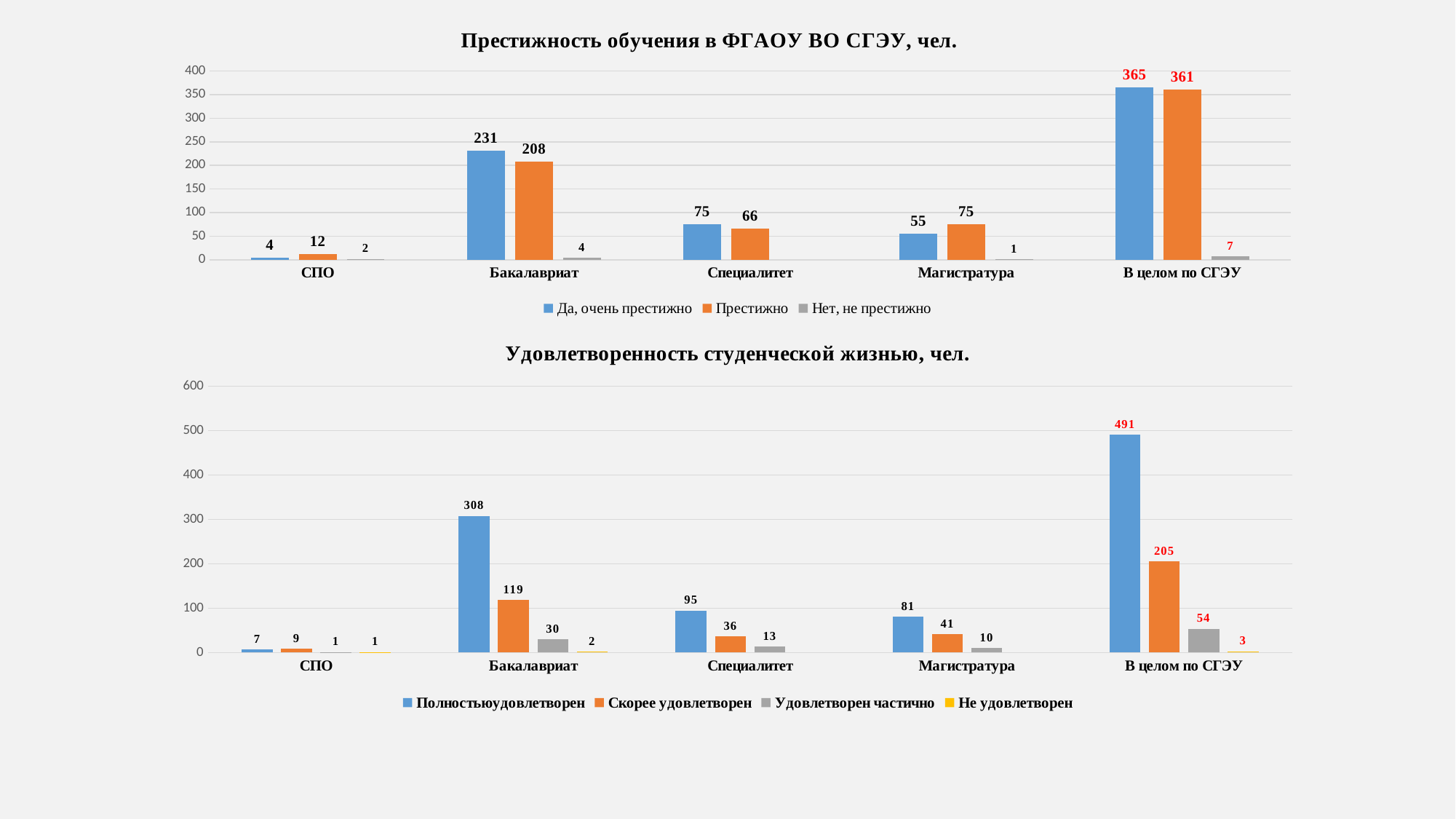
In the chart 'Престижность обучения в ФГАОУ ВО СГЭУ, чел.', what is the difference between 'Да, очень престижно' and 'Престижно' in the 'В целом по СГЭУ' category? 4 In the chart 'Удовлетворенность студенческой жизнью, чел.', what is the value for 'Удовлетворен частично' in the 'В целом по СГЭУ' category? 54 In the chart 'Удовлетворенность студенческой жизнью, чел.', what is the value for 'Полностью удовлетворен' in the 'Бакалавриат' category? 308 In the chart 'Престижность обучения в ФГАОУ ВО СГЭУ, чел.', what is the value for 'Да, очень престижно' in the 'Бакалавриат' category? 231 In the chart 'Престижность обучения в ФГАОУ ВО СГЭУ, чел.', which category has the highest value for 'Нет, не престижно'? В целом по СГЭУ In the chart 'Удовлетворенность студенческой жизнью, чел.', what is the difference between 'Полностью удовлетворен' and 'Скорее удовлетворен' in the 'Магистратура' category? 40 In the chart 'Престижность обучения в ФГАОУ ВО СГЭУ, чел.', what is the value for 'Престижно' in the 'Магистратура' category? 75 In the chart 'Престижность обучения в ФГАОУ ВО СГЭУ, чел.', which is larger in the 'Специалитет' category: 'Да, очень престижно' or 'Престижно'? Да, очень престижно In the chart 'Престижность обучения в ФГАОУ ВО СГЭУ, чел.', how many series does the legend list? 3 What kind of chart is 'Удовлетворенность студенческой жизнью, чел.'? Bar chart In the chart 'Удовлетворенность студенческой жизнью, чел.', which category has the lowest value for 'Скорее удовлетворен'? СПО In the chart 'Удовлетворенность студенческой жизнью, чел.', how many series does the legend list? 4